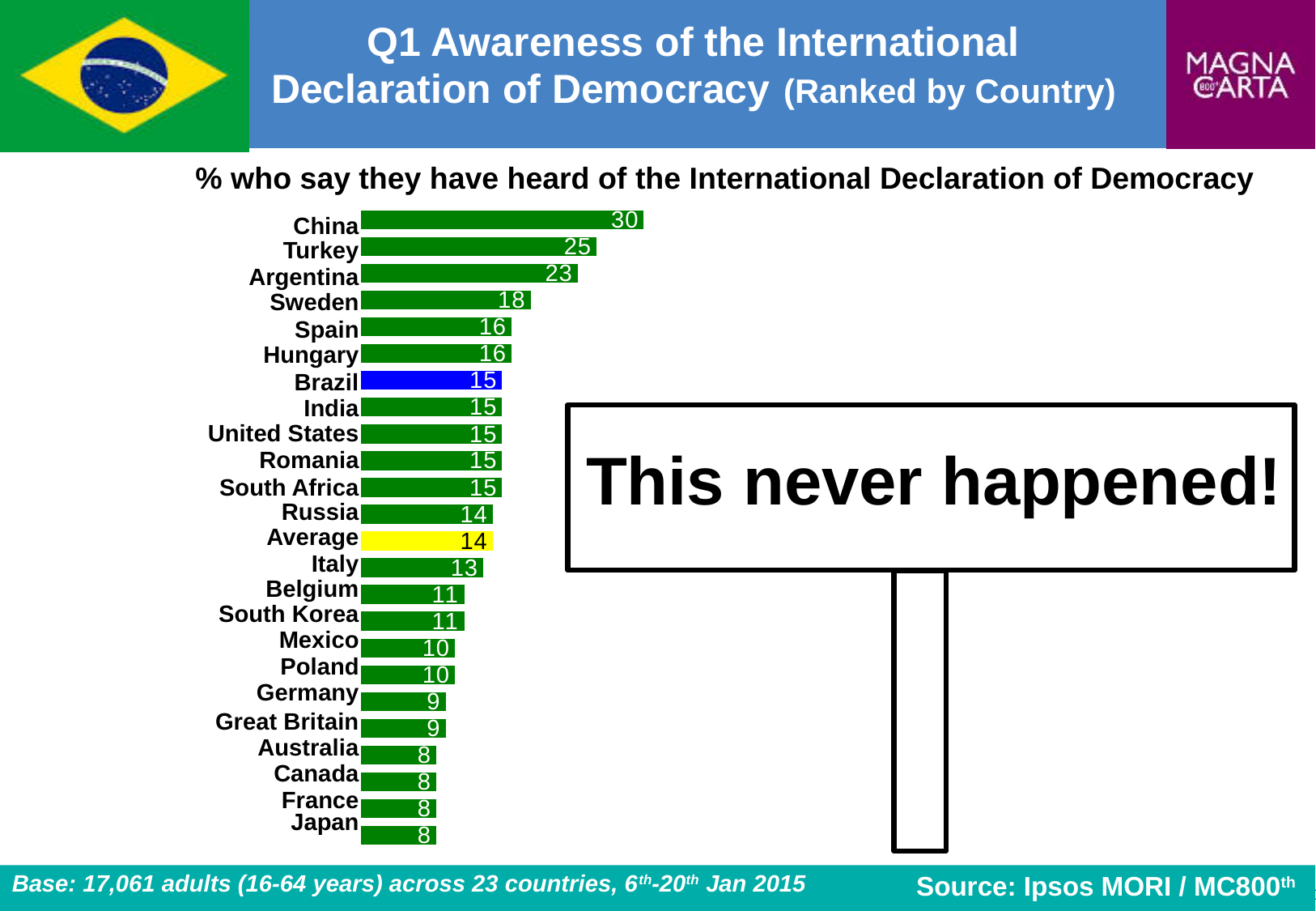
What is the difference between the values for Argentina and Italy? 10 Which has a larger value, Turkey or Argentina? Turkey What value is shown for the Average bar? 14 What value is shown for China? 30 What kind of chart is shown? Bar chart What is the difference between the values for China and Turkey? 5 Which bar is coloured blue? Brazil How many bars are plotted, including the Average bar? 24 Which has a larger value, Russia or Belgium? Russia What value is shown for Brazil? 15 Which country has the highest value? China What value is shown for Sweden? 18